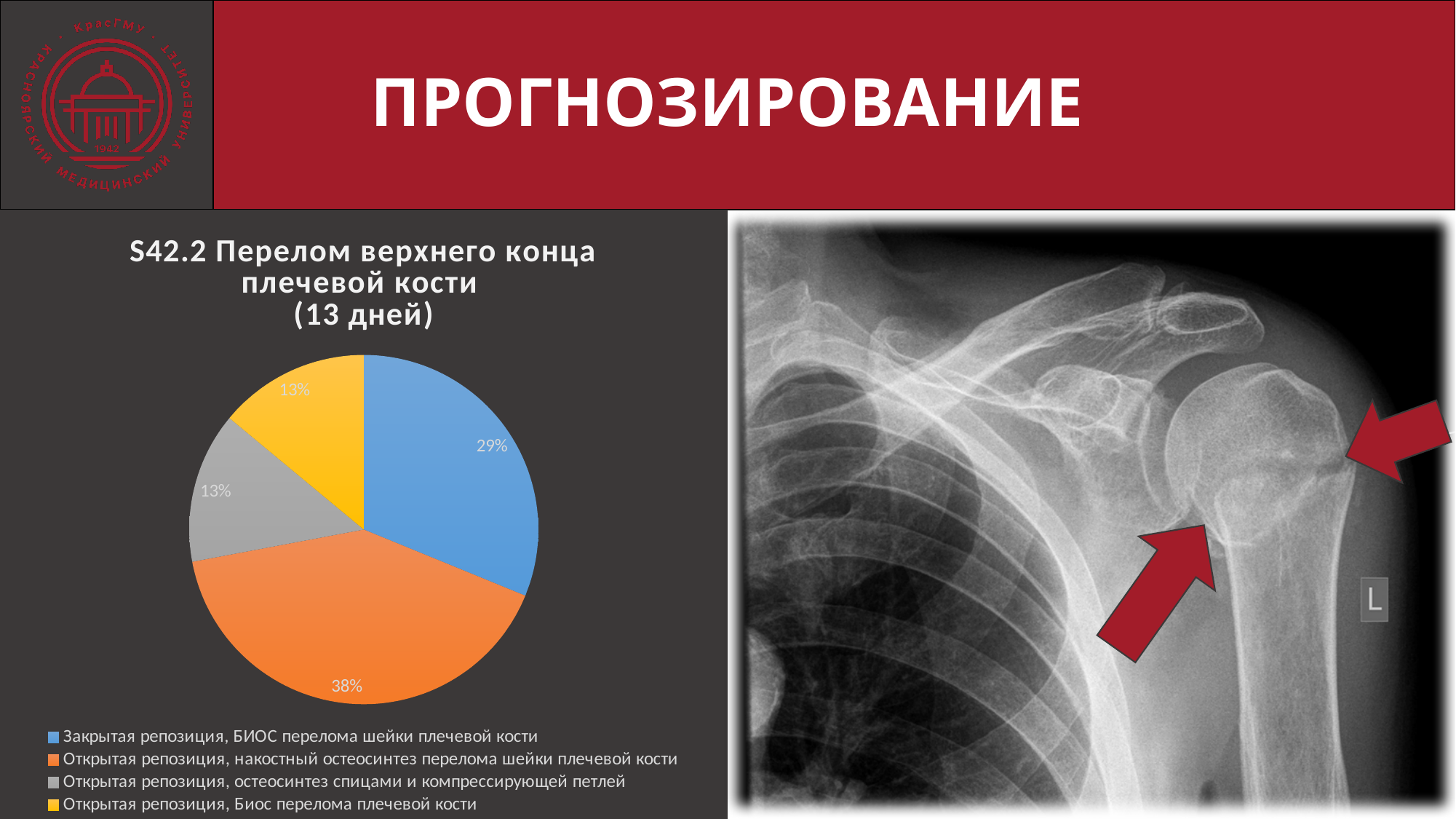
What share of the pie does "Закрытая репозиция, БИОС перелома шейки плечевой кости" have? 29% What colour is the slice for "Открытая репозиция, Биос перелома плечевой кости"? yellow What share of the pie does "Открытая репозиция, Биос перелома плечевой кости" have? 13% What share of the pie does "Открытая репозиция, остеосинтез спицами и компрессирующей петлей" have? 13% How many slices does the pie chart have? 4 What kind of chart is shown on the slide? pie chart What is the difference in percentage points between the "Открытая репозиция, накостный остеосинтез перелома шейки плечевой кости" slice and the "Закрытая репозиция, БИОС перелома шейки плечевой кости" slice? 9% What is the title of the pie chart? S42.2 Перелом верхнего конца плечевой кости (13 дней) What is the difference in percentage points between the "Закрытая репозиция, БИОС перелома шейки плечевой кости" slice and the "Открытая репозиция, Биос перелома плечевой кости" slice? 16% Which category has the largest slice of the pie? Открытая репозиция, накостный остеосинтез перелома шейки плечевой кости Which is larger: the slice for "Закрытая репозиция, БИОС перелома шейки плечевой кости" or the slice for "Открытая репозиция, накостный остеосинтез перелома шейки плечевой кости"? Открытая репозиция, накостный остеосинтез перелома шейки плечевой кости